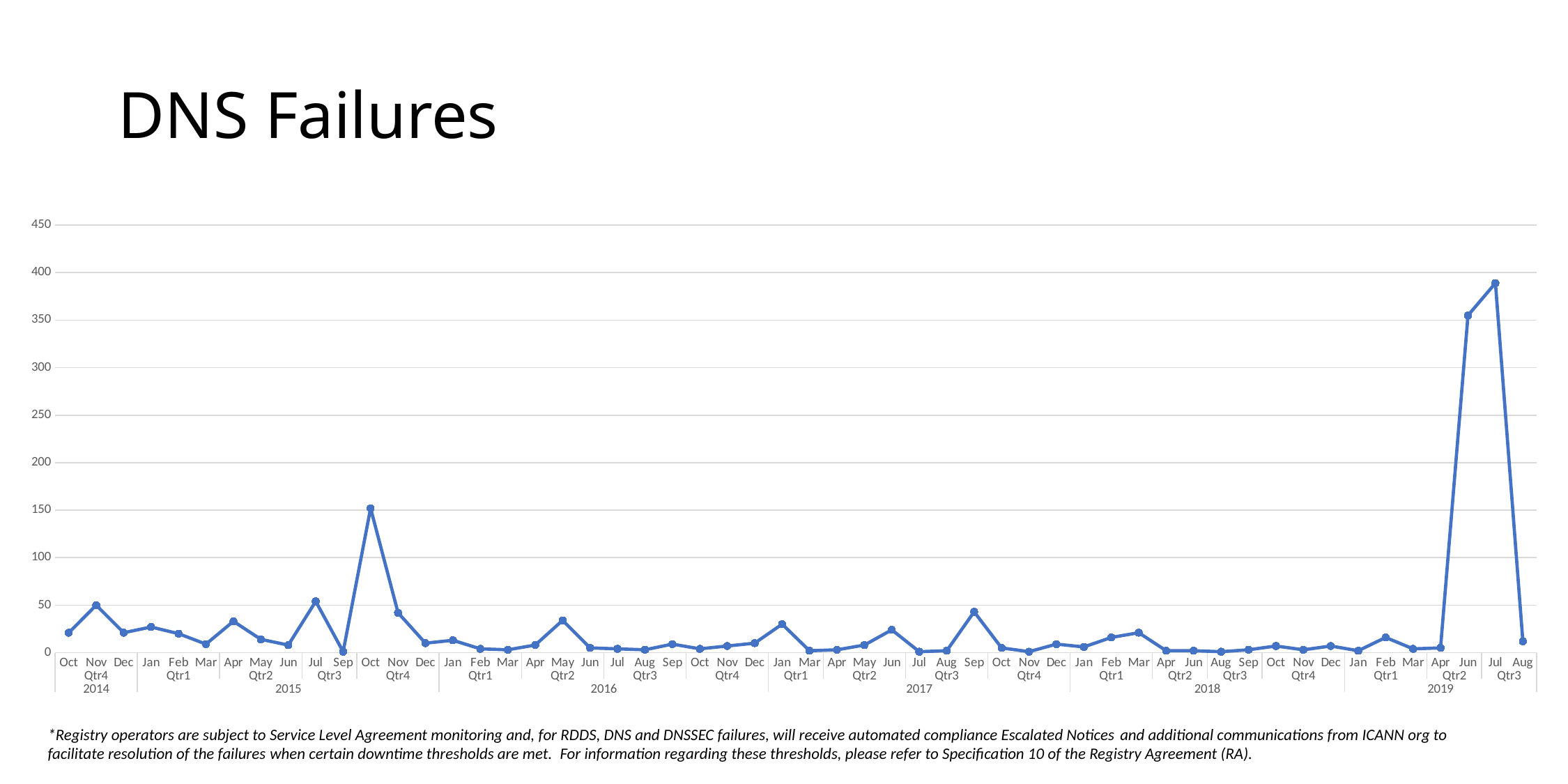
Is the value for Oct 2015 greater or less than 100? greater Is the value for Jun 2019 greater or less than 300? greater Which is larger, the value for Oct 2015 or the value for Nov 2014? Oct 2015 In which month and year does the line reach its highest value? Jul 2019 What kind of chart is shown on the slide? line chart What is the first year shown on the x axis? 2014 Which is larger, the value for Jul 2019 or the value for Oct 2015? Jul 2019 Does the line rise or fall from Jul 2019 to Aug 2019? fall Is the value for Jul 2019 greater or less than 350? greater What is the title of the chart? DNS Failures